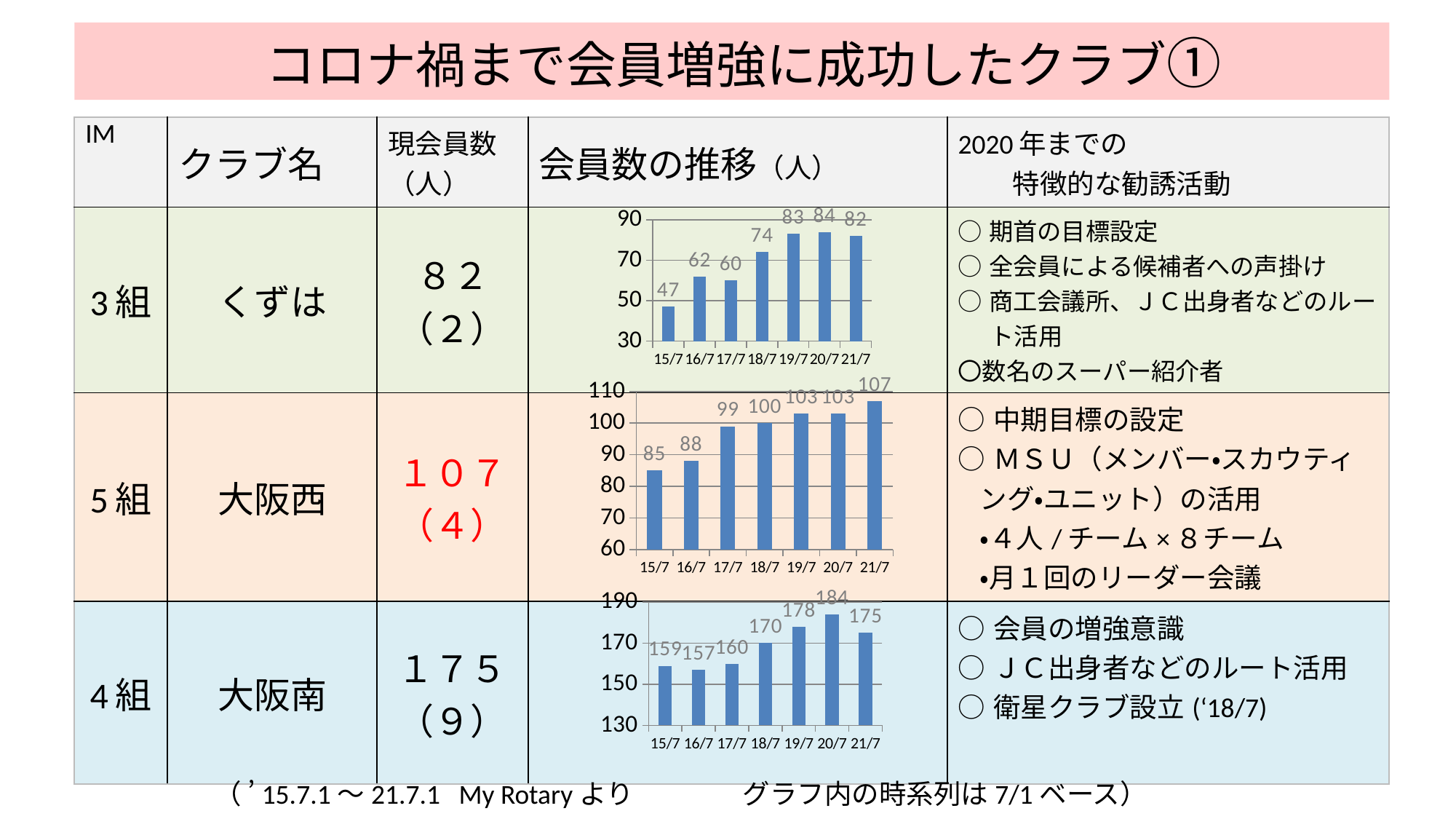
In the middle chart (大阪西), which period has the lowest value? 15/7 In the bottom chart (大阪南), is the value for 19/7 greater or less than 170? greater In the middle chart (大阪西), how many bars are plotted? 7 In the bottom chart (大阪南), what is the value for 20/7? 184 In the bottom chart (大阪南), what is the difference between the values for 20/7 and 21/7? 9 What type of chart is used to show the membership trend for each club? Bar chart In the middle chart (大阪西), what is the value for 21/7? 107 In the top chart (くずは), what is the value for 15/7? 47 In the top chart (くずは), which period has the highest value? 20/7 In the top chart (くずは), what is the difference between the values for 21/7 and 15/7? 35 In the bottom chart (大阪南), which is larger, the value for 16/7 or the value for 18/7? 18/7 In the middle chart (大阪西), do the values generally rise or fall from 15/7 to 21/7? Rise